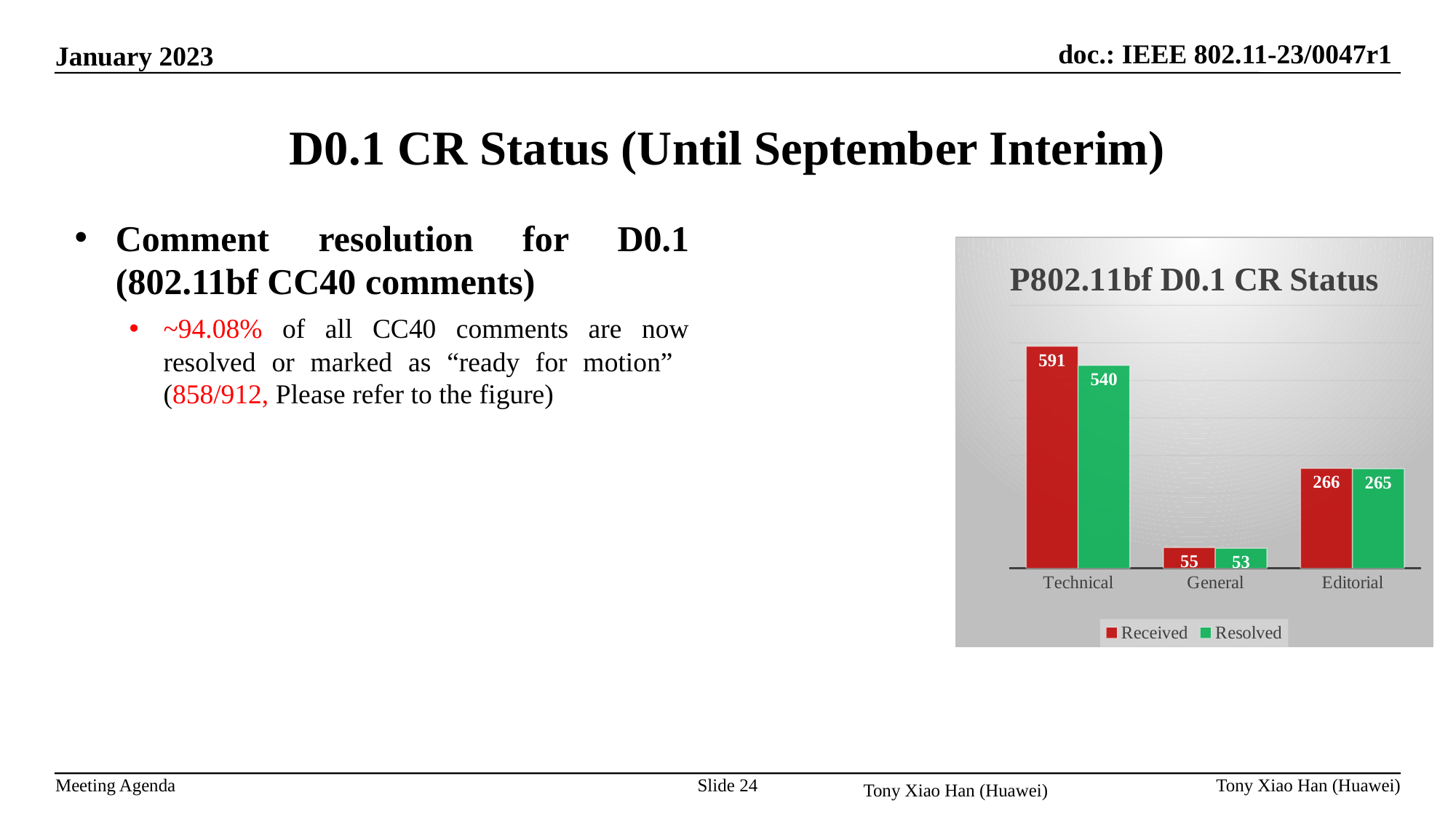
How many categories are shown on the x axis? 3 What is the difference between Received and Resolved for Technical? 51 What is the Resolved value for General? 53 Which category has the highest Received value? Technical What is the Received value for Editorial? 266 How many series does the legend list? 2 Which is larger, the Received value for Technical or the Received value for Editorial? Technical What is the Received value for Technical? 591 Which category has the lowest Resolved value? General What kind of chart is shown? Bar chart What is the difference between Received and Resolved for Editorial? 1 What is the title of the chart? P802.11bf D0.1 CR Status